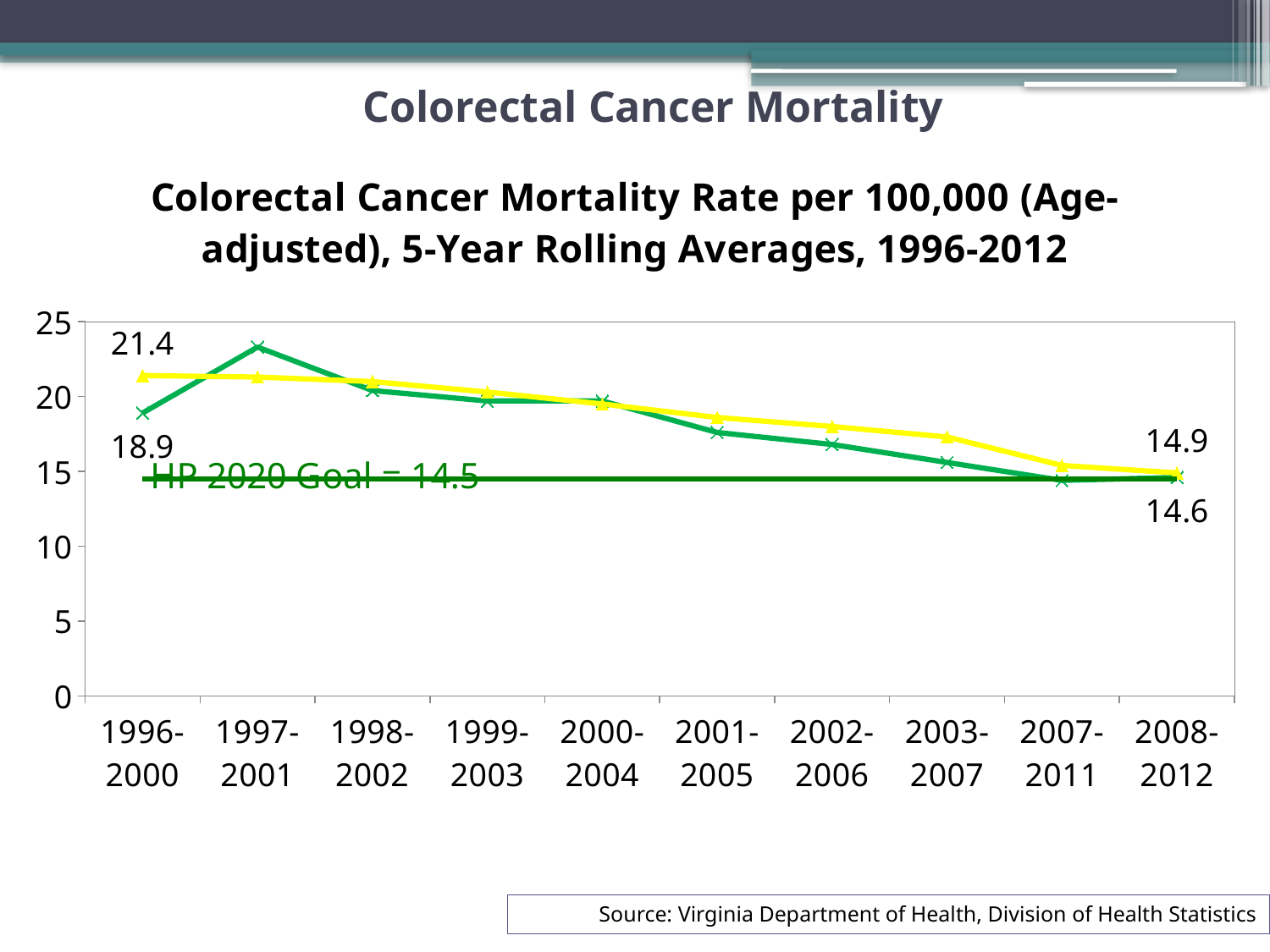
What is the value of the green line with x markers for 1996-2000? 18.9 What type of chart is shown on the slide? line chart Is the value of the green line with x markers for 1997-2001 greater or less than 20? greater What is the difference between the yellow line's value for 1996-2000 and its value for 2008-2012? 6.5 What is the value of the yellow line for 1996-2000? 21.4 What is the value of the yellow line for 2008-2012? 14.9 Which is larger for 1996-2000, the yellow line's value or the green line's value? the yellow line's value What is the HP 2020 Goal value shown on the chart? 14.5 What is the value of the green line with x markers for 2008-2012? 14.6 How many time periods are shown on the x axis? 10 Does the yellow line generally rise or fall from 1996-2000 to 2008-2012? fall What is the difference between the green line's value for 1996-2000 and its value for 2008-2012? 4.3